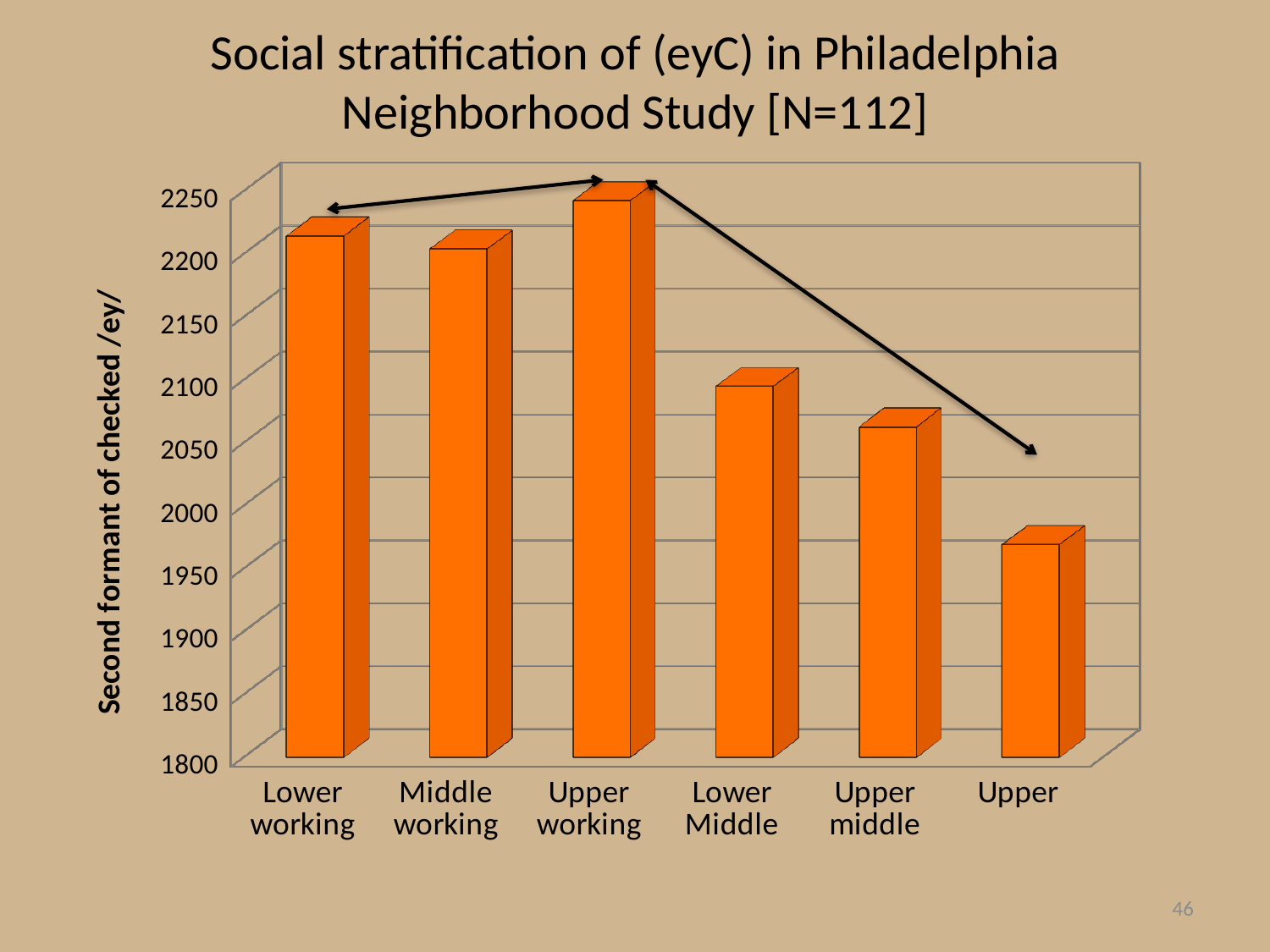
How many social class categories are plotted on the x axis? 6 Which is larger, the value for Upper working or the value for Upper? Upper working Which category has the highest second formant value? Upper working Do the values rise or fall from Upper working to Upper along the x axis? fall Is the value for Lower working greater or less than 2150? greater Which category has the lowest second formant value? Upper Is the value for Lower Middle greater or less than 2050? greater Is the value for Upper greater or less than 2000? less What kind of chart is shown on the slide? Bar chart What is the label of the vertical axis? Second formant of checked /ey/ Which is larger, the value for Upper working or the value for Lower Middle? Upper working